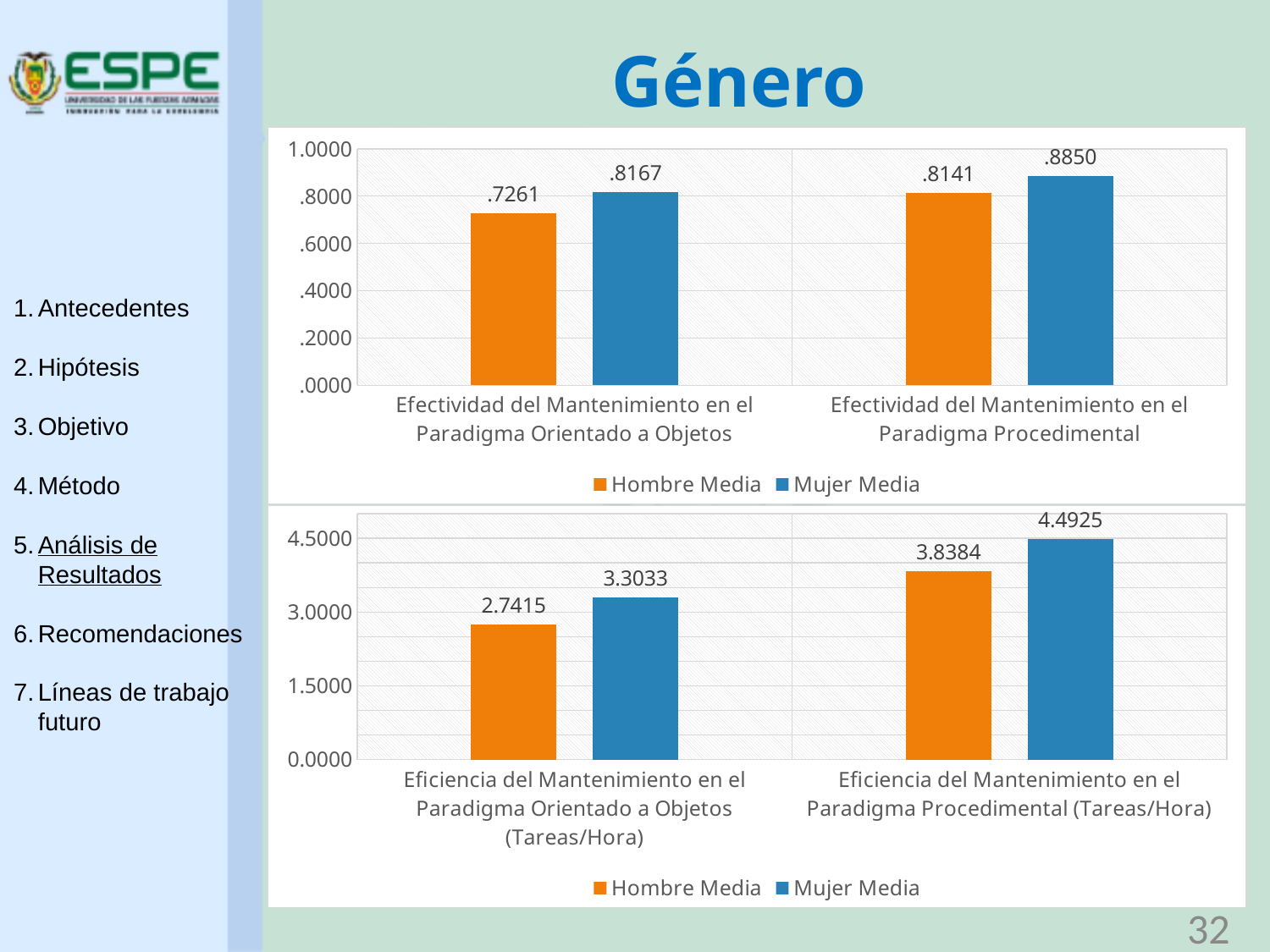
In the top chart, which bar has the highest value? Mujer Media, Efectividad del Mantenimiento en el Paradigma Procedimental In the bottom chart, which bar has the lowest value? Hombre Media, Eficiencia del Mantenimiento en el Paradigma Orientado a Objetos (Tareas/Hora) In the top chart, what is the difference between the Mujer Media and Hombre Media values for Efectividad del Mantenimiento en el Paradigma Orientado a Objetos? .0906 In the top chart, which is larger: the Hombre Media value for the Paradigma Procedimental or the Mujer Media value for the Paradigma Orientado a Objetos? Mujer Media for the Paradigma Orientado a Objetos In the bottom chart, what is the difference between the Mujer Media and Hombre Media values for Eficiencia del Mantenimiento en el Paradigma Procedimental (Tareas/Hora)? 0.6541 What kind of chart is the top chart? Bar chart In the bottom chart, what is the Mujer Media value for Eficiencia del Mantenimiento en el Paradigma Orientado a Objetos (Tareas/Hora)? 3.3033 In the top chart, what is the Mujer Media value for Efectividad del Mantenimiento en el Paradigma Procedimental? .8850 In the top chart, what is the Hombre Media value for Efectividad del Mantenimiento en el Paradigma Orientado a Objetos? .7261 In the bottom chart, which colour represents Hombre Media? Orange In the bottom chart, what is the Hombre Media value for Eficiencia del Mantenimiento en el Paradigma Procedimental (Tareas/Hora)? 3.8384 How many series does the legend of the bottom chart list? 2